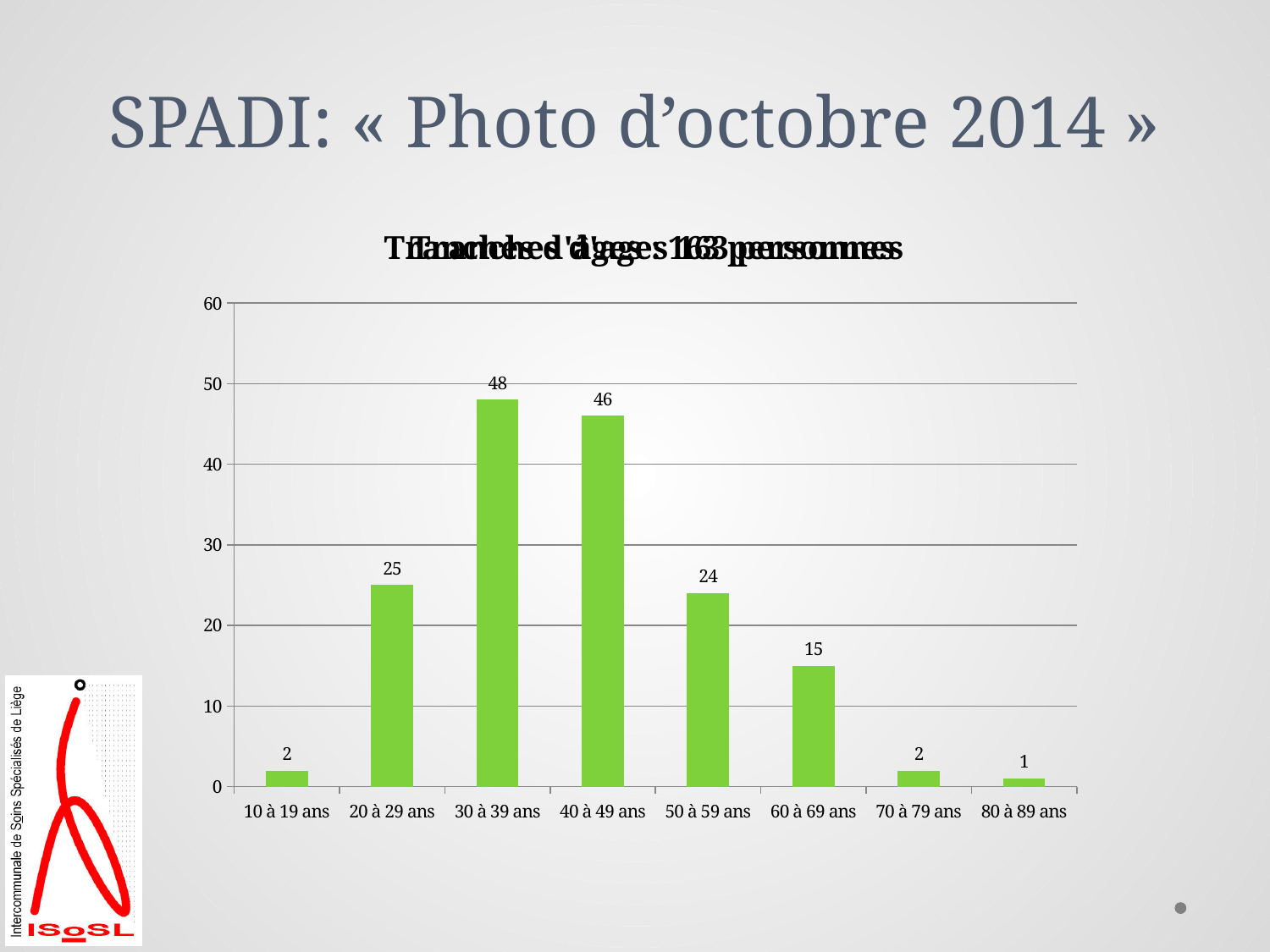
What is the difference between the values for 30 à 39 ans and 40 à 49 ans? 2 Which age category has the lowest value? 80 à 89 ans Which is larger, the value for 20 à 29 ans or the value for 50 à 59 ans? 20 à 29 ans What colour are the bars in the chart? green What kind of chart is shown on the slide? bar chart What is the difference between the values for 20 à 29 ans and 60 à 69 ans? 10 Which age category has the highest value? 30 à 39 ans What is the value for the 30 à 39 ans category? 48 How many age categories are shown on the x axis? 8 What is the value for the 60 à 69 ans category? 15 What is the value for the 80 à 89 ans category? 1 What is the value for the 50 à 59 ans category? 24